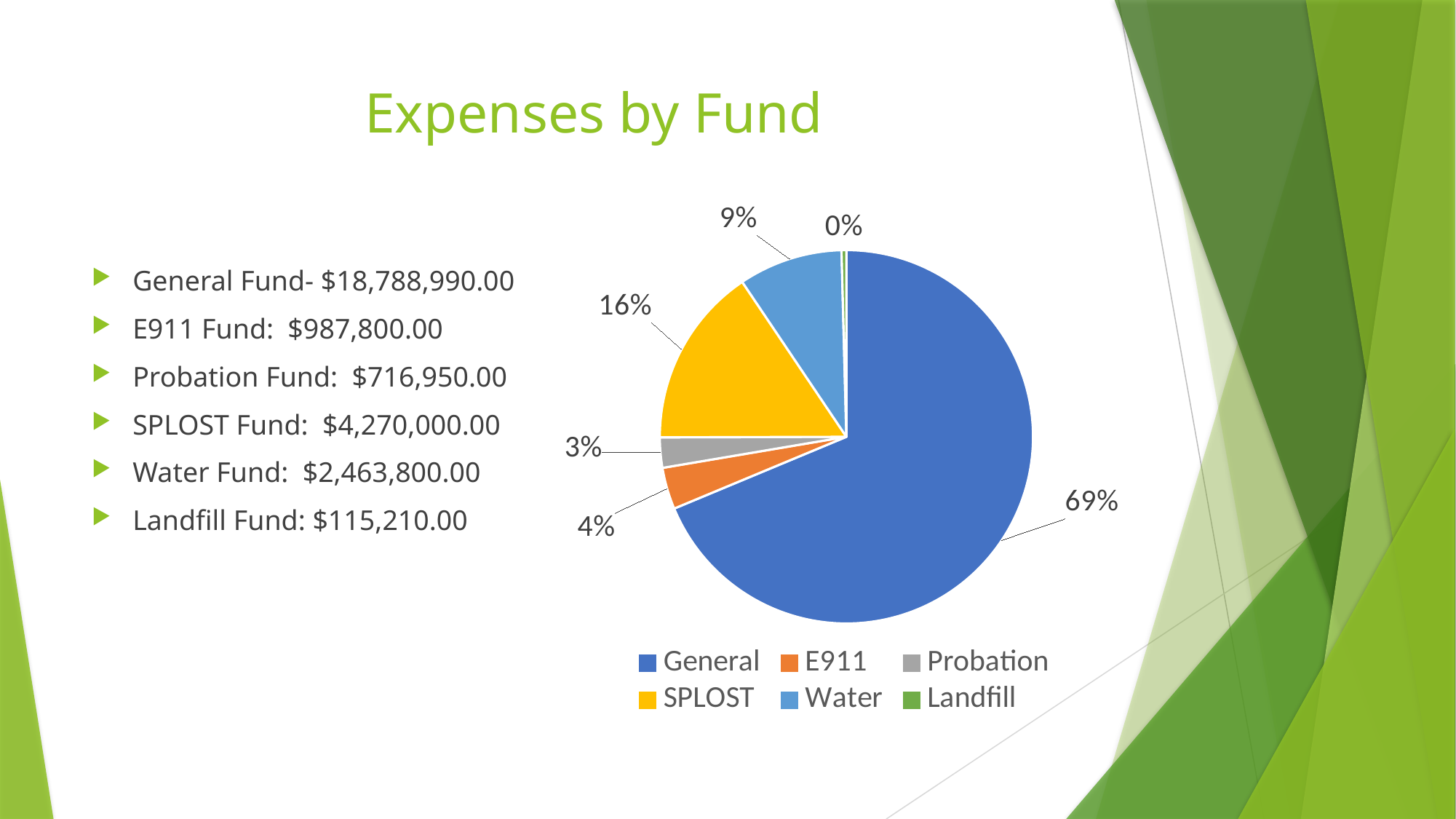
What kind of chart is shown on the slide? pie chart What percentage share does the Probation slice have in the pie chart? 3% What is the title of the chart on the slide? Expenses by Fund What percentage share does the General slice have in the pie chart? 69% What percentage share does the SPLOST slice have in the pie chart? 16% Which fund has the smallest slice in the pie chart? Landfill Which slice is larger in the pie chart, SPLOST or Water? SPLOST Which fund has the largest slice in the pie chart? General How many slices does the pie chart have? 6